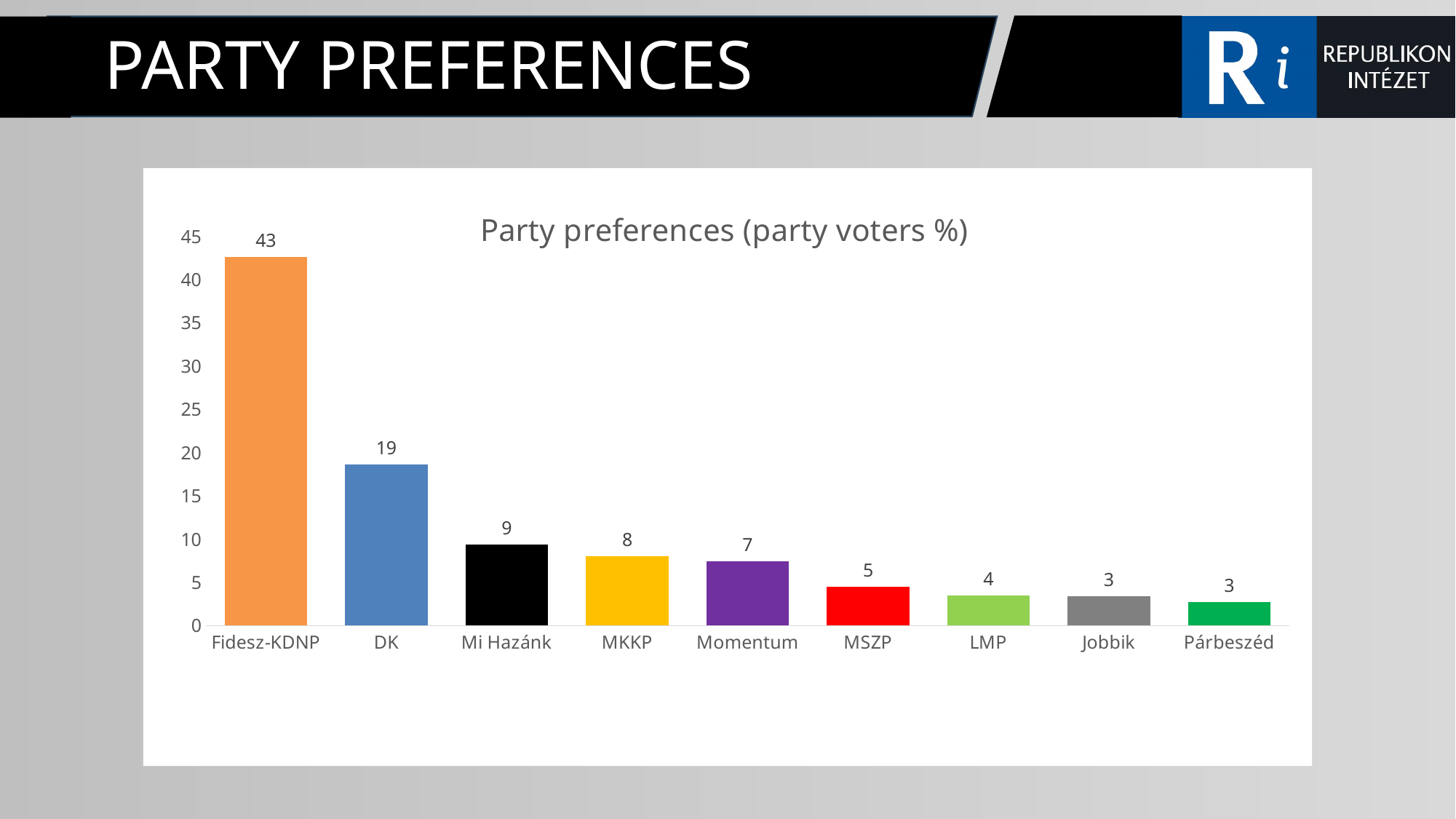
What is the title of the chart? Party preferences (party voters %) What is the value for Momentum? 7 What is the value for Fidesz-KDNP? 43 Is the value for DK greater or less than 15? greater What is the value for MSZP? 5 What is the value for DK? 19 What kind of chart is shown? Bar chart What is the difference between the values for Mi Hazánk and MKKP? 1 Which is larger, the value for MKKP or the value for LMP? MKKP How many parties are shown on the x axis? 9 Which party has the highest value? Fidesz-KDNP What is the difference between the values for Fidesz-KDNP and DK? 24